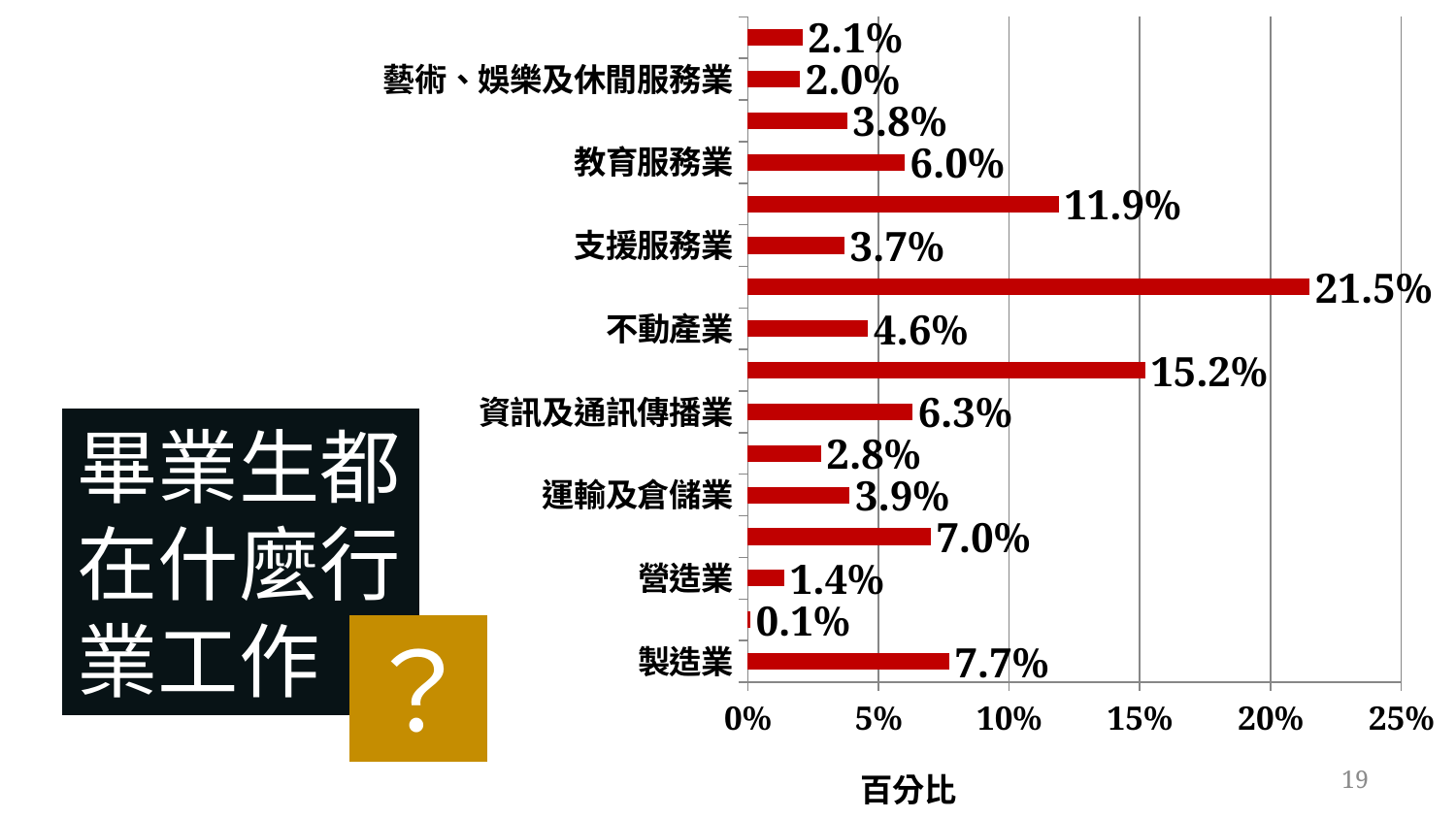
What is the title of the horizontal axis? 百分比 What is the largest value shown on the chart? 21.5% What is the value for 營造業? 1.4% What is the difference between the values for 製造業 and 運輸及倉儲業? 3.8% What is the value for 藝術、娛樂及休閒服務業? 2.0% What is the value for 資訊及通訊傳播業? 6.3% What kind of chart is shown on the slide? bar chart Which is larger, the value for 不動產業 or the value for 支援服務業? 不動產業 What is the smallest value shown on the chart? 0.1% What is the value for 教育服務業? 6.0% How many bars are plotted on the chart? 16 What is the value for 製造業? 7.7%